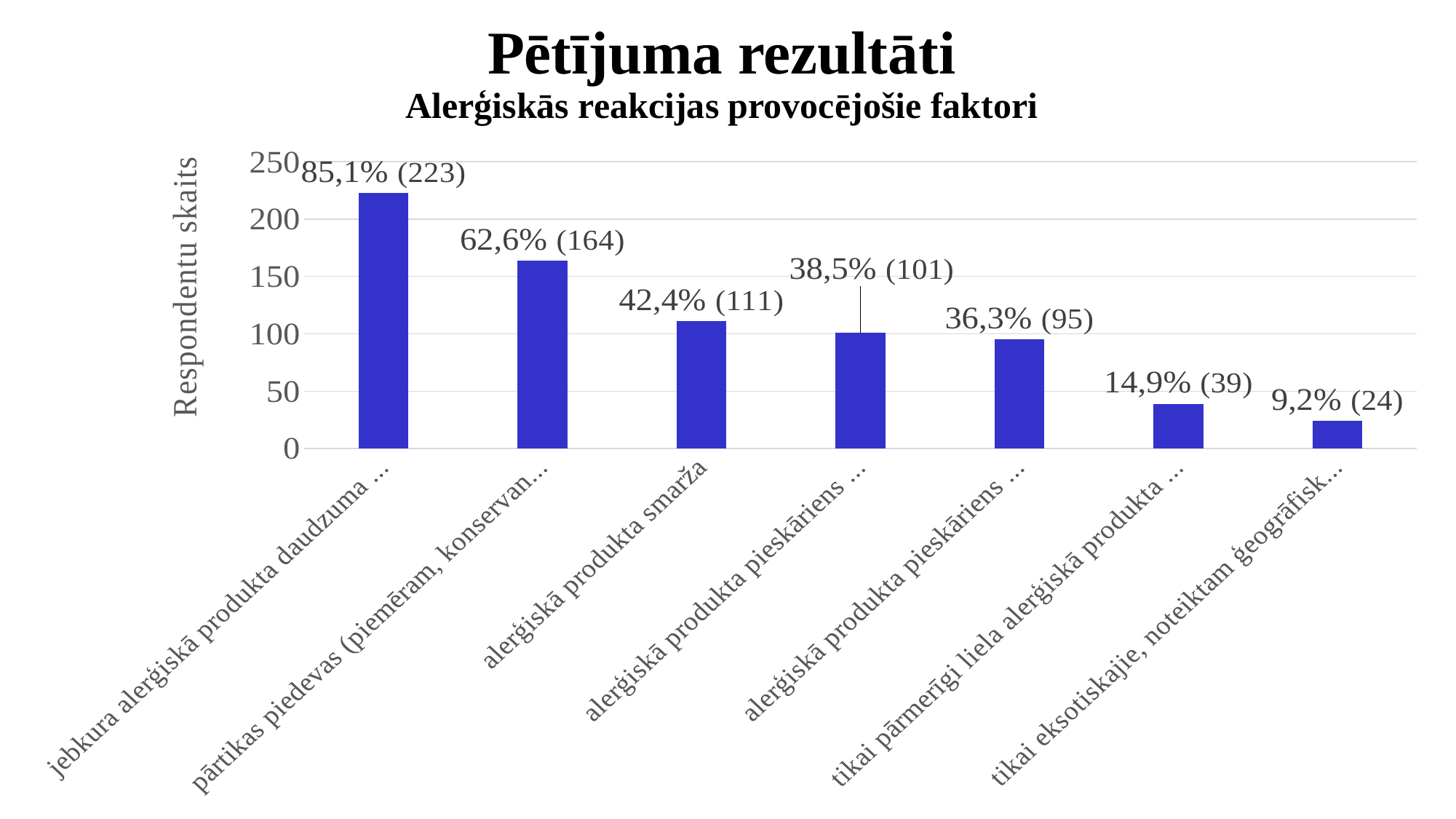
What is the data label on the last (rightmost) bar? 9,2% (24) Which bar has the highest value? the first (leftmost) bar Which bar has the lowest value? the last (rightmost) bar Which is larger: the value for "alerģiskā produkta smarža" or the value of the fourth bar? alerģiskā produkta smarža What type of chart is shown on the slide? bar chart What is the data label on the first (leftmost) bar? 85,1% (223) What is the difference in respondent count between the first bar (223) and the second bar (164)? 59 Do the bar values rise or fall from left to right along the x axis? fall How many bars are plotted in the chart? 7 What is the data label on the second bar from the left? 62,6% (164) What is the label of the vertical axis? Respondentu skaits What is the data label on the bar for "alerģiskā produkta smarža"? 42,4% (111)